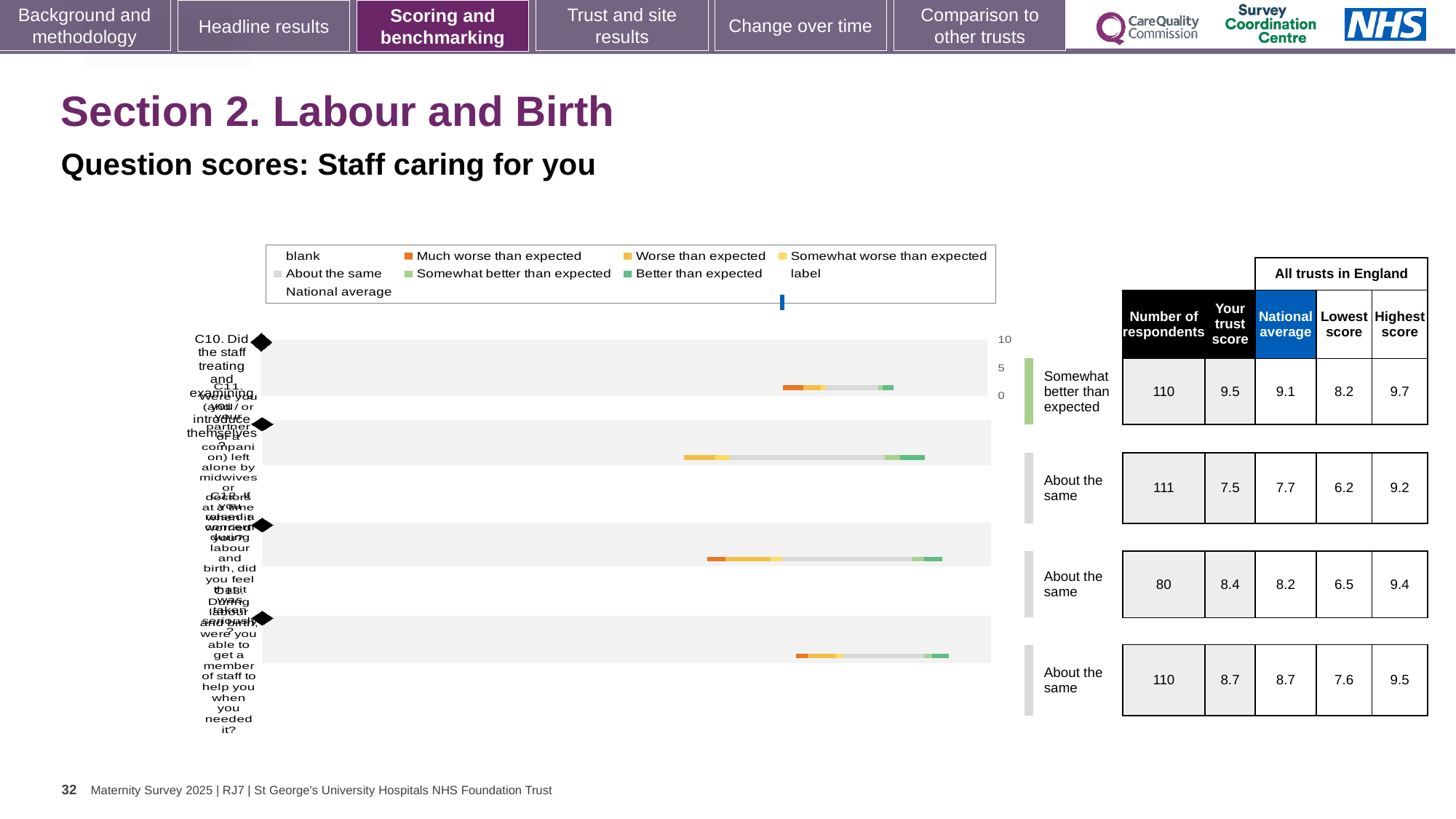
In the table, what is the Number of respondents for the third row? 80 In the table, what is the 'Your trust score' for the first row? 9.5 In the third row of the table, which is larger: 'Your trust score' or the National average? Your trust score What is the subtitle of the chart on the slide? Question scores: Staff caring for you What is the difference between 'Your trust score' and the National average in the first row of the table? 0.4 In the table, what is the Highest score for the fourth row? 9.5 Which row of the table has the highest 'Your trust score'? the first row In the table, what is the Lowest score for the second row? 6.2 What benchmark label is shown next to the first bar? Somewhat better than expected How many question bars are plotted in the chart? 4 What kind of chart is shown on the slide? bar chart In the table, what is the National average for the first row? 9.1